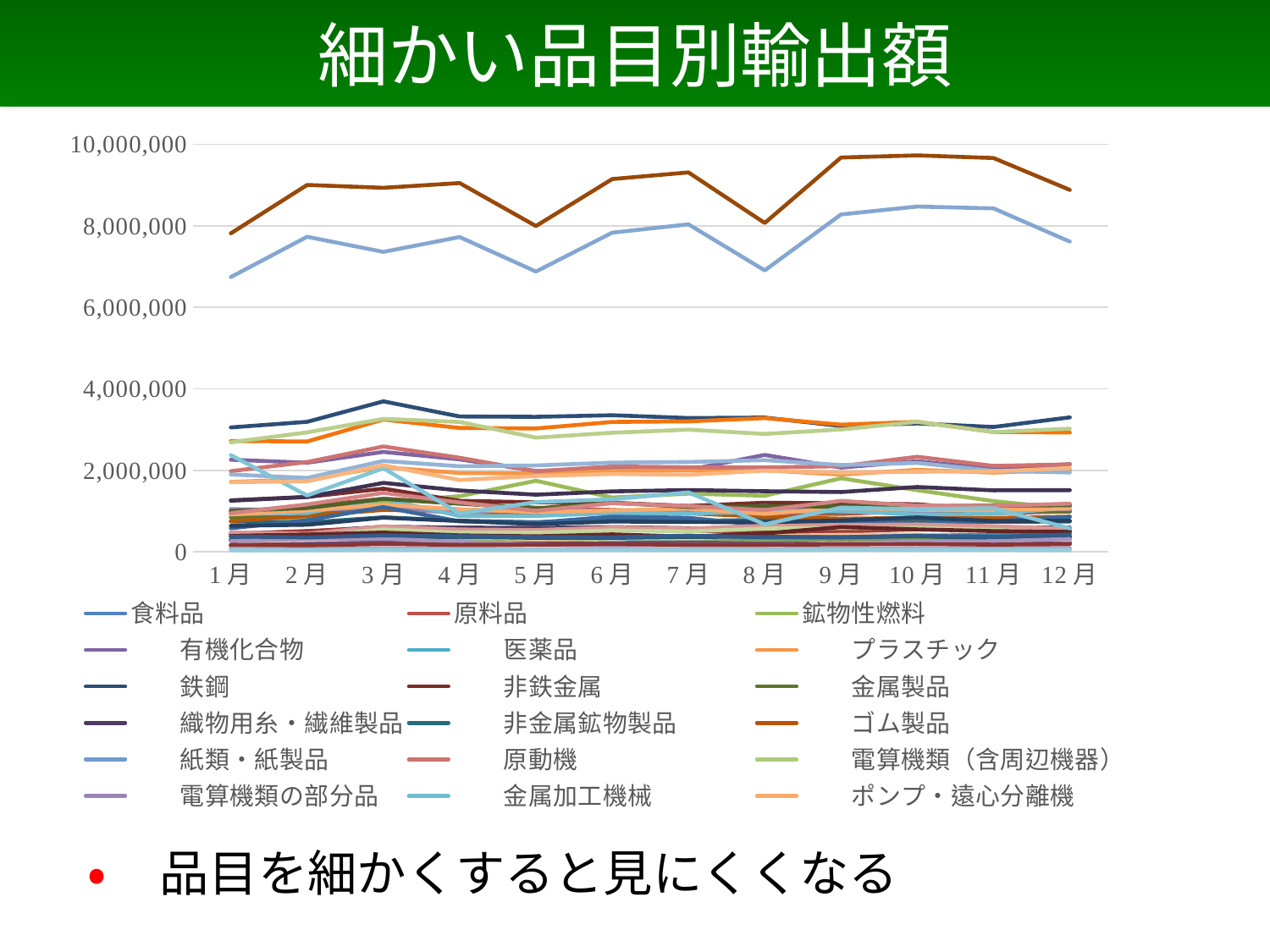
What is the highest value shown on the y axis? 10,000,000 What is the title of the chart? 細かい品目別輸出額 In which month does the topmost line reach its lowest value? 1月 Is the value of the topmost line in 5月 greater or less than 6,000,000? greater Is the value of the second-highest line in 10月 greater or less than 8,000,000? greater Does the topmost line rise or fall from 8月 to 9月? rise How many months are shown along the x axis? 12 Does the topmost line rise or fall from 7月 to 8月? fall Is the value of the second-highest line in 5月 greater or less than 8,000,000? less How many series does the legend list? 18 What kind of chart is shown on the slide? line chart